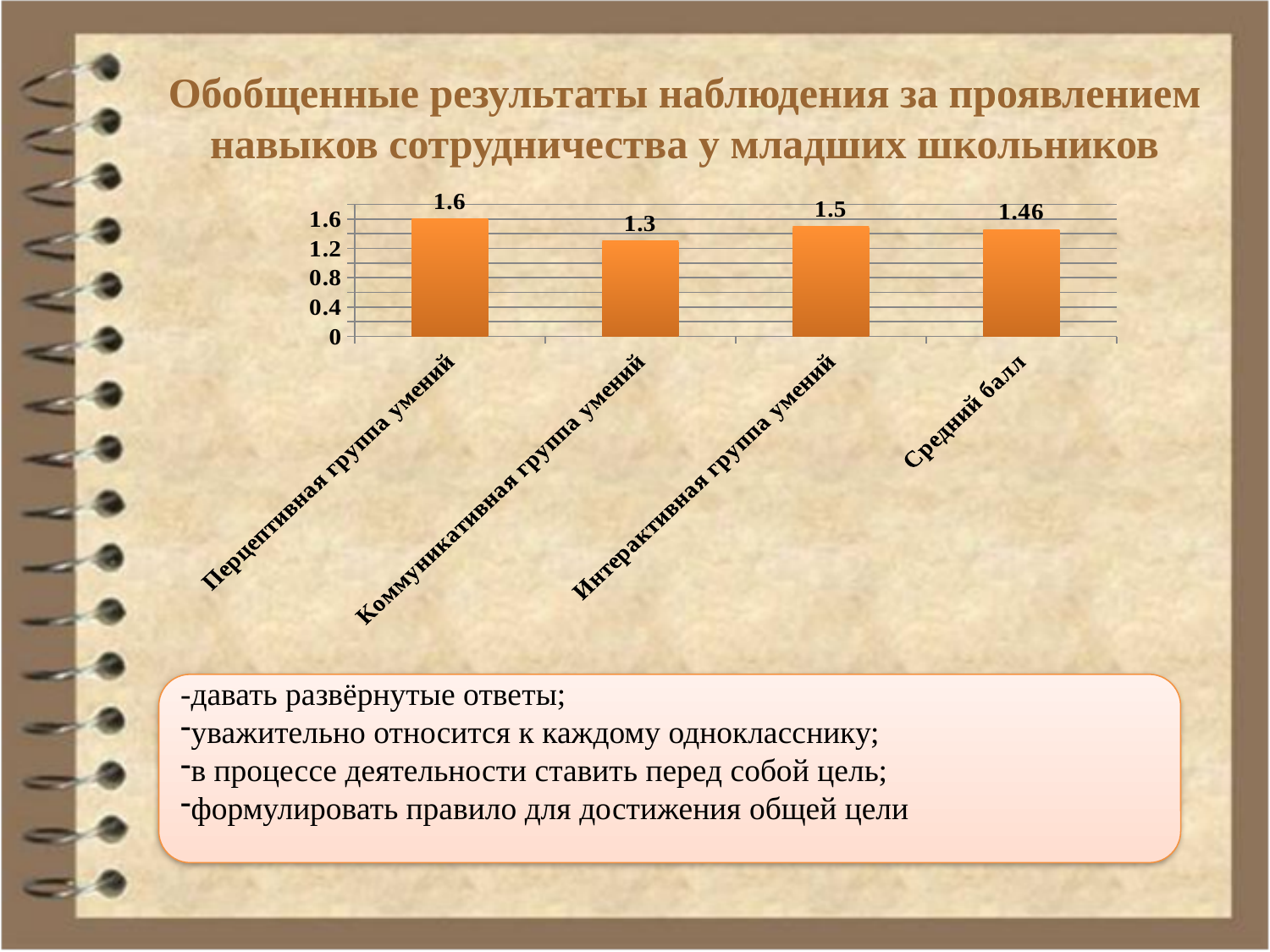
Is the value for Коммуникативная группа умений greater or less than 1.2? greater What is the value for Средний балл? 1.46 What colour are the bars in the chart? orange Which category has the highest value? Перцептивная группа умений What is the value for Коммуникативная группа умений? 1.3 What is the difference between the values for Перцептивная группа умений and Коммуникативная группа умений? 0.3 How many categories are shown on the chart? 4 Which is larger, the value for Интерактивная группа умений or the value for Коммуникативная группа умений? Интерактивная группа умений What kind of chart is shown on the slide? bar chart What is the value for Интерактивная группа умений? 1.5 What is the value for Перцептивная группа умений? 1.6 Which category has the lowest value? Коммуникативная группа умений